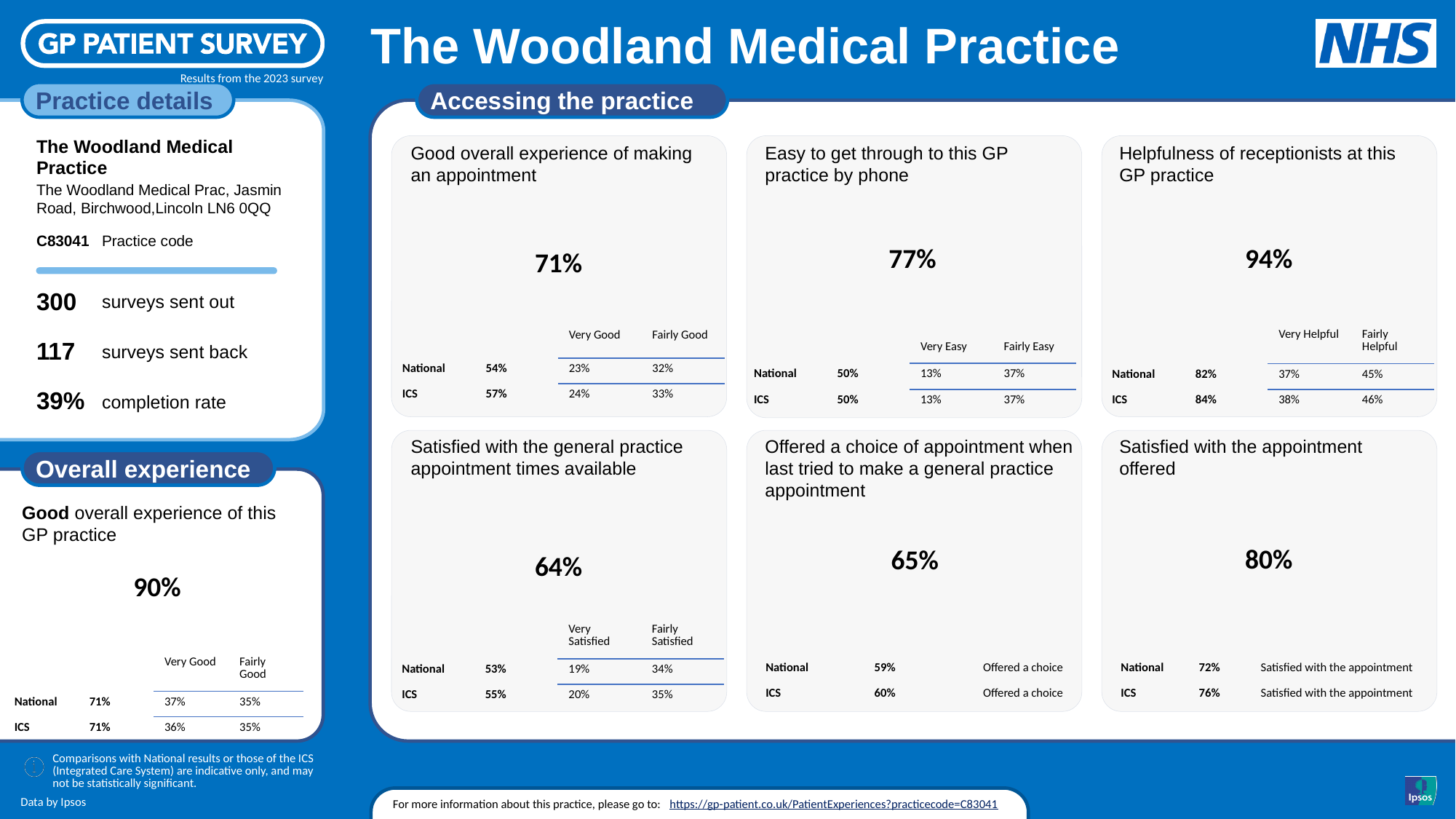
In the 'Good overall experience of making an appointment' panel, what is the National value for Fairly Good? 32% In the 'Good overall experience of this GP practice' panel under Overall experience, what is the practice's headline percentage? 90% In the 'Good overall experience of making an appointment' panel, what is the practice's headline percentage? 71% In the 'Easy to get through to this GP practice by phone' panel, what is the difference between the practice's headline percentage and the National value? 27% In the 'Satisfied with the appointment offered' panel, which is larger, the National value or the ICS value? ICS In the 'Helpfulness of receptionists at this GP practice' panel, what is the National value? 82% In the 'Satisfied with the appointment offered' panel, what is the ICS value? 76% In the 'Satisfied with the general practice appointment times available' panel, what is the ICS value for Very Satisfied? 20% In the 'Offered a choice of appointment when last tried to make a general practice appointment' panel, what is the National value? 59% Among the six 'Accessing the practice' panels, which has the highest headline percentage? Helpfulness of receptionists at this GP practice Among the six 'Accessing the practice' panels, which has the lowest headline percentage? Satisfied with the general practice appointment times available In the 'Easy to get through to this GP practice by phone' panel, what is the practice's headline percentage? 77%